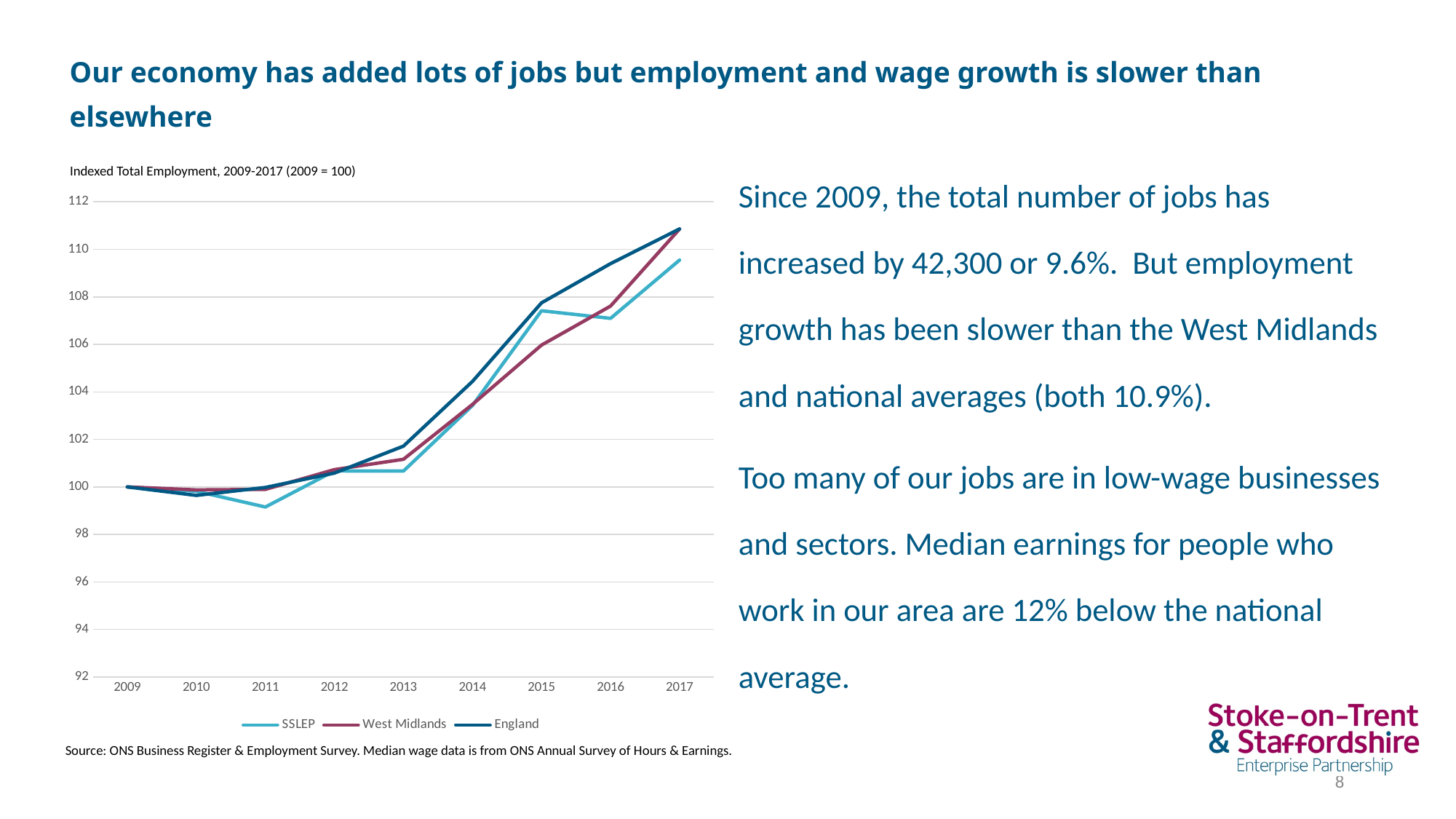
How many series does the chart's legend list? 3 In 2017, which is higher: England or SSLEP? England What is the indexed employment value for SSLEP in 2009? 100 Overall, do the values for England rise or fall from 2009 to 2017? Rise What kind of chart is shown on the slide? Line chart Is the value for SSLEP in 2011 greater or less than 100? less In which year does the SSLEP line reach its lowest value? 2011 What is the title of the chart? Indexed Total Employment, 2009-2017 (2009 = 100) Is the value for England in 2017 greater or less than 110? greater How many years are plotted along the x axis of the chart? 9 In 2015, which is higher: SSLEP or West Midlands? SSLEP Is the value for SSLEP in 2017 greater or less than 108? greater